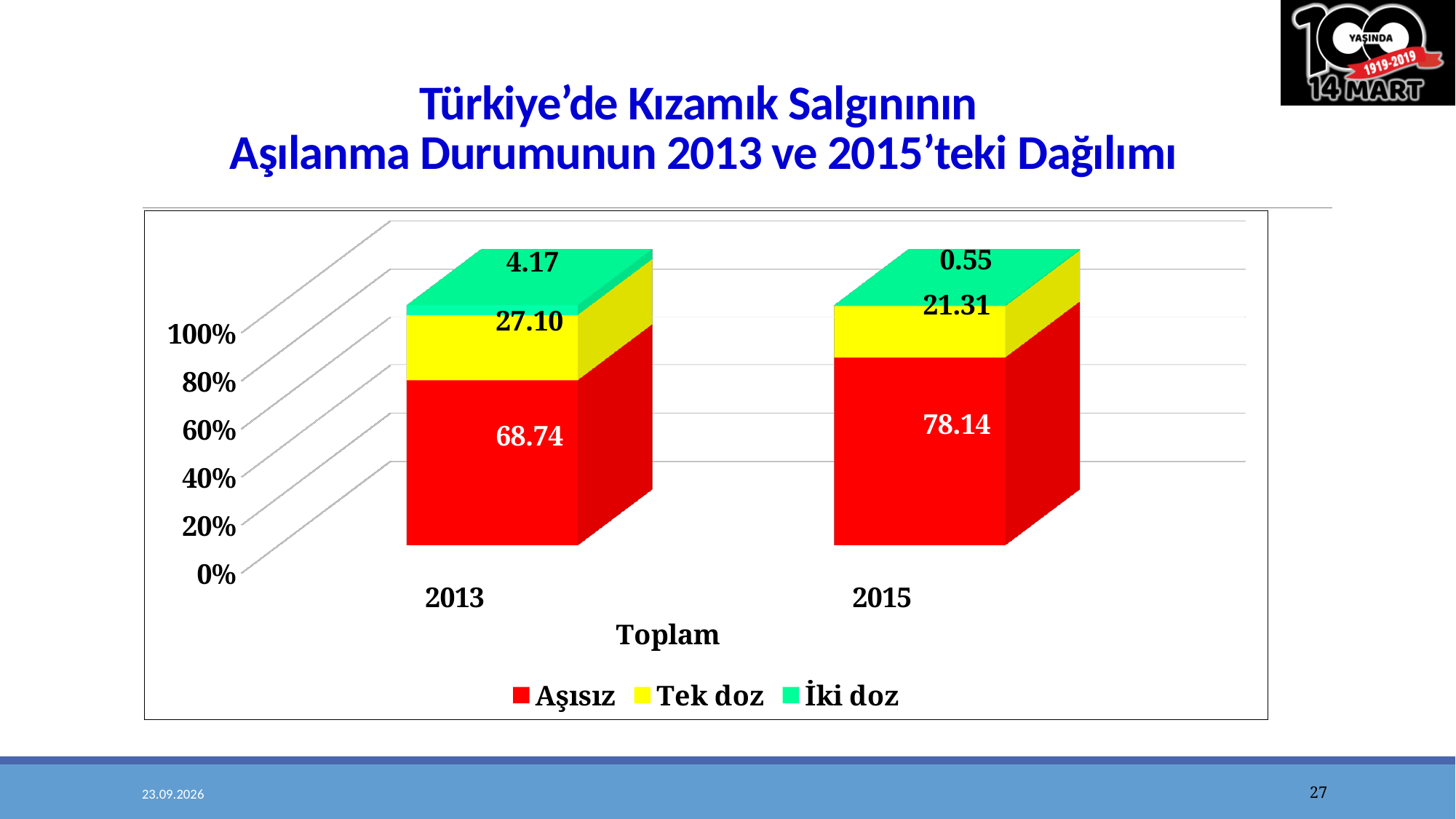
What is the value of Aşısız for 2013? 68.74 Is the Tek doz value larger in 2013 or in 2015? 2013 How many categories are shown on the x axis? 2 What is the total of the stacked bar for 2015? 100.00 What is the value of Tek doz for 2015? 21.31 Which series has the largest value in 2013? Aşısız How many series does the legend list? 3 What is the difference between the Aşısız values for 2015 and 2013? 9.40 What kind of chart is shown on the slide? Stacked bar chart What is the value of Aşısız for 2015? 78.14 What is the value of İki doz for 2013? 4.17 Which series has the smallest value in 2015? İki doz